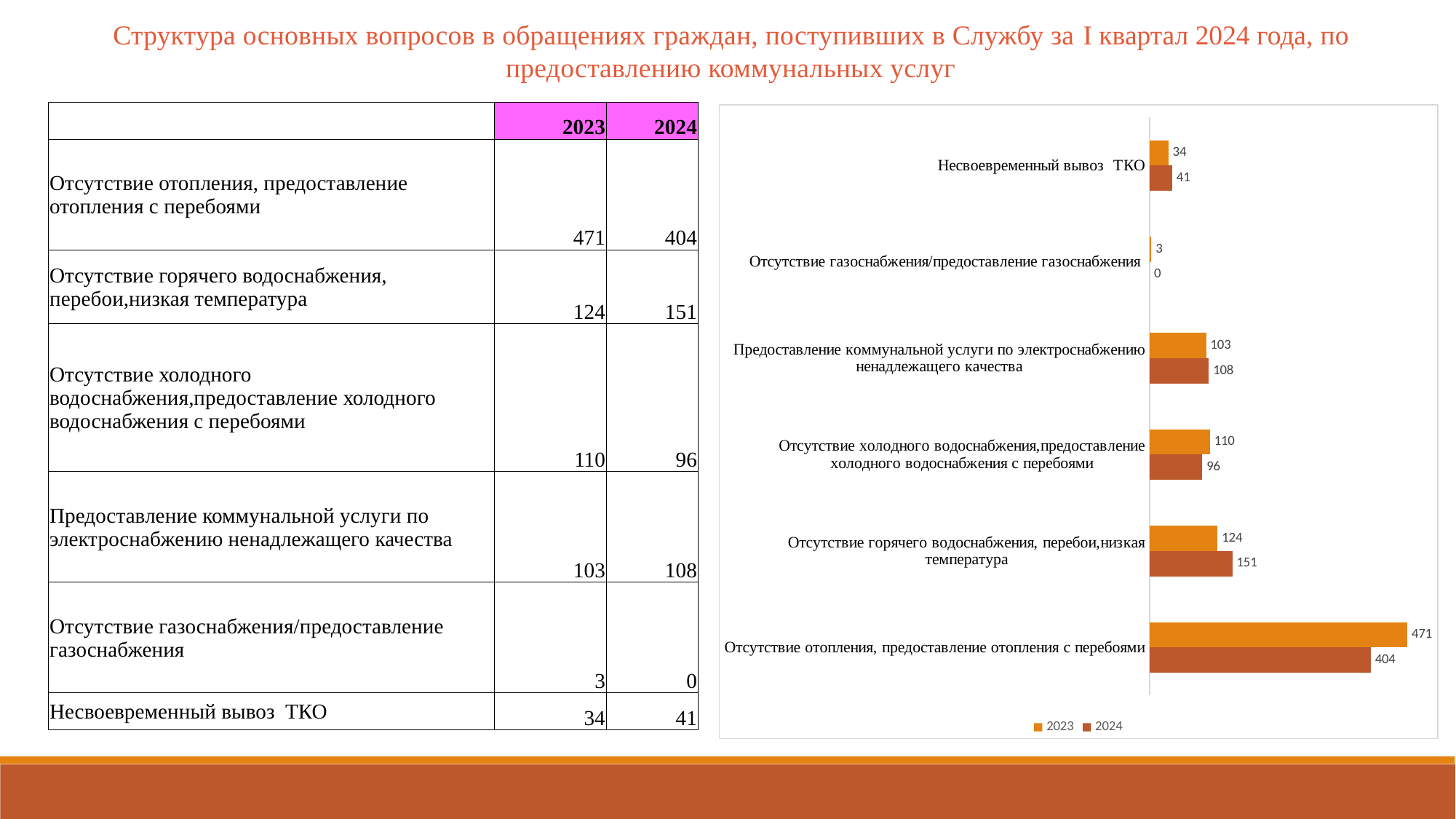
For "Предоставление коммунальной услуги по электроснабжению ненадлежащего качества", which year has the larger value, 2023 or 2024? 2024 Which category has the highest 2023 value in the chart? Отсутствие отопления, предоставление отопления с перебоями How many categories are shown in the chart? 6 How many series does the chart legend list? 2 What is the 2024 value for "Отсутствие газоснабжения/предоставление газоснабжения" in the chart? 0 What is the difference between the 2024 and 2023 values for "Отсутствие горячего водоснабжения, перебои,низкая температура"? 27 What is the difference between the 2023 and 2024 values for "Отсутствие отопления, предоставление отопления с перебоями"? 67 What is the 2023 value for "Отсутствие горячего водоснабжения, перебои,низкая температура" in the chart? 124 What type of chart is shown on the slide? Bar chart What is the 2024 value for "Несвоевременный вывоз ТКО" in the chart? 41 Which category has the lowest 2024 value in the chart? Отсутствие газоснабжения/предоставление газоснабжения For "Отсутствие холодного водоснабжения,предоставление холодного водоснабжения с перебоями", which year has the larger value, 2023 or 2024? 2023